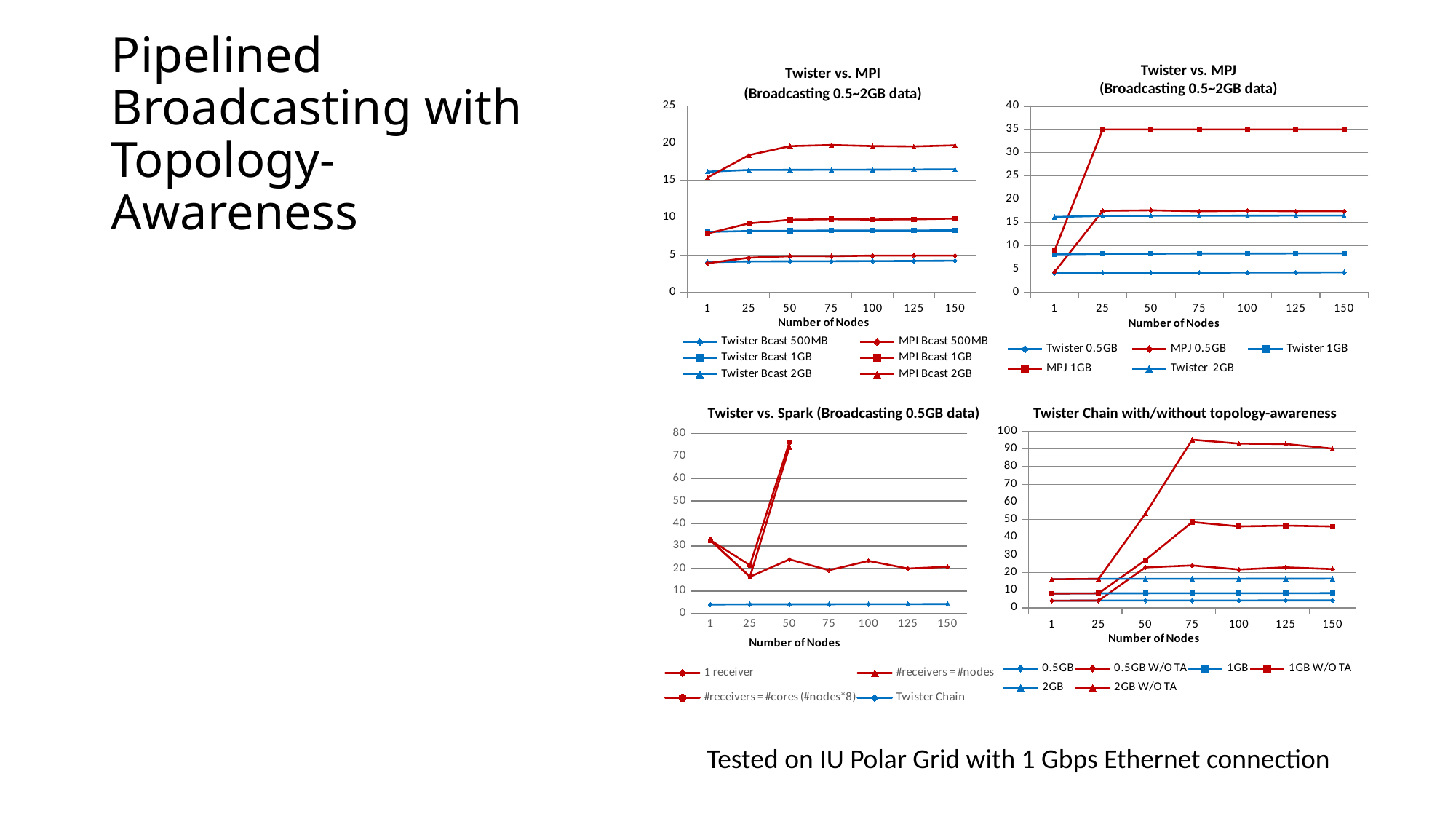
In the "Twister vs. Spark" chart, is the value for Twister Chain at 100 nodes greater or less than 10? less In the "Twister vs. MPJ" chart, which is larger at 150 nodes: MPJ 1GB or Twister 2GB? MPJ 1GB How many series does the legend of the "Twister vs. MPI" chart list? 6 What kind of chart is the "Twister vs. MPI" chart? Line chart What is the x-axis title of the "Twister Chain with/without topology-awareness" chart? Number of Nodes In the "Twister vs. MPJ" chart, is the value for MPJ 1GB at 100 nodes greater or less than 30? greater In the "Twister vs. MPJ" chart, does the MPJ 1GB line rise or fall between 1 and 25 nodes? Rises How many series does the legend of the "Twister vs. Spark" chart list? 4 In the "Twister Chain with/without topology-awareness" chart, which series reaches the highest value? 2GB W/O TA How many node counts are plotted along the x axis of the "Twister vs. MPI" chart? 7 In the "Twister vs. MPI" chart, is the value for MPI Bcast 2GB at 150 nodes greater or less than 15? greater How many series does the legend of the "Twister vs. MPJ" chart list? 5